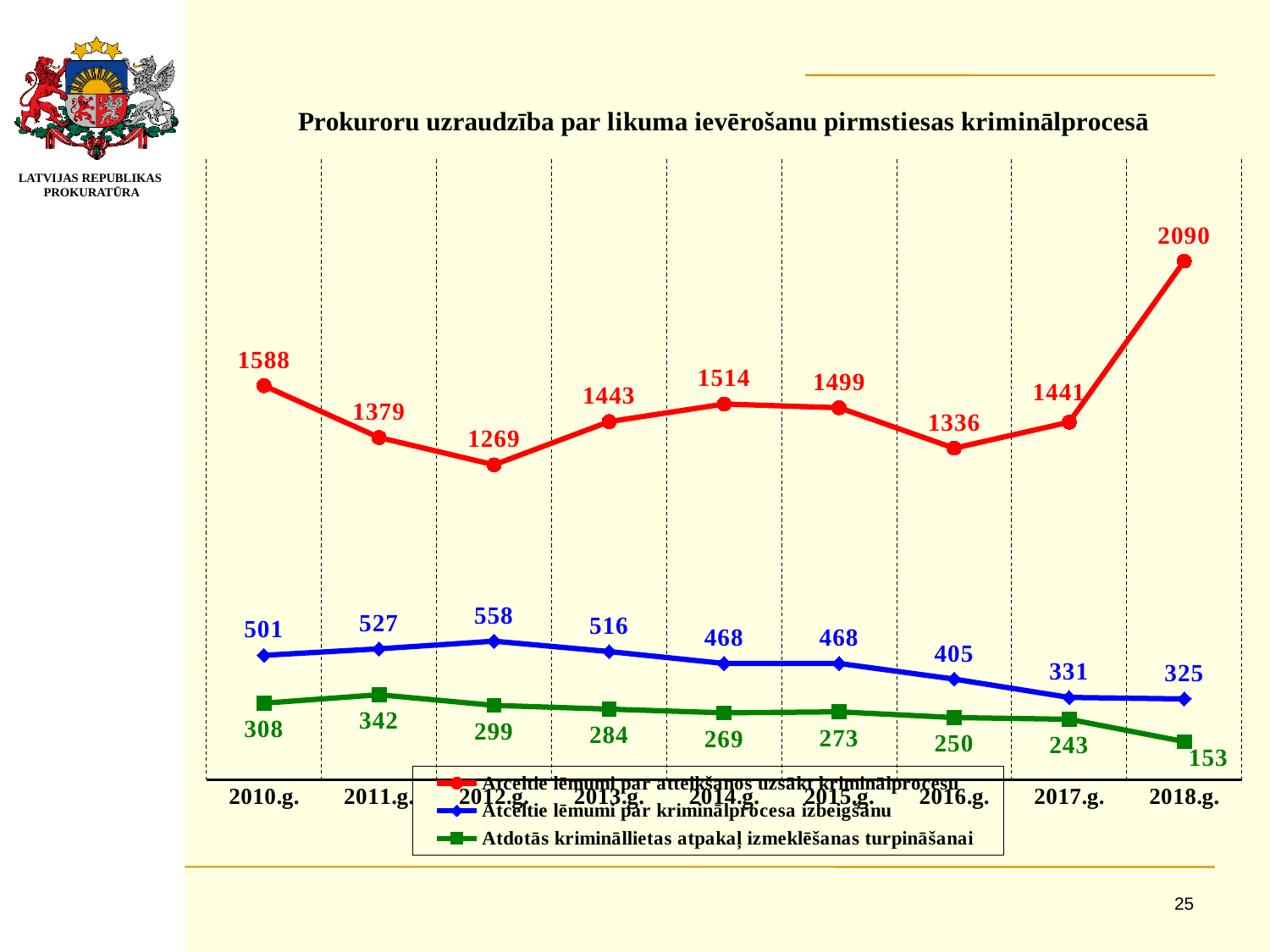
How many years are shown on the x axis? 9 In which year does the green series reach its lowest value? 2018.g. In which year does the blue series reach its highest value? 2012.g. What is the difference between the red series values in 2018.g. and 2017.g.? 649 Which is larger: the blue series value in 2010.g. or in 2018.g.? 2010.g. What is the value of the blue series (Atceltie lēmumi par kriminālprocesa izbeigšanu) in 2012.g.? 558 What is the value of the green series (Atdotās krimināllietas atpakaļ izmeklēšanas turpināšanai) in 2011.g.? 342 In which year does the red series reach its lowest value? 2012.g. How many series does the legend list? 3 What is the value of the red series (Atceltie lēmumi par atteikšanos uzsākt kriminālprocesu) in 2018.g.? 2090 What kind of chart is shown on the slide? Line chart Does the blue series rise or fall from 2012.g. to 2018.g.? Fall